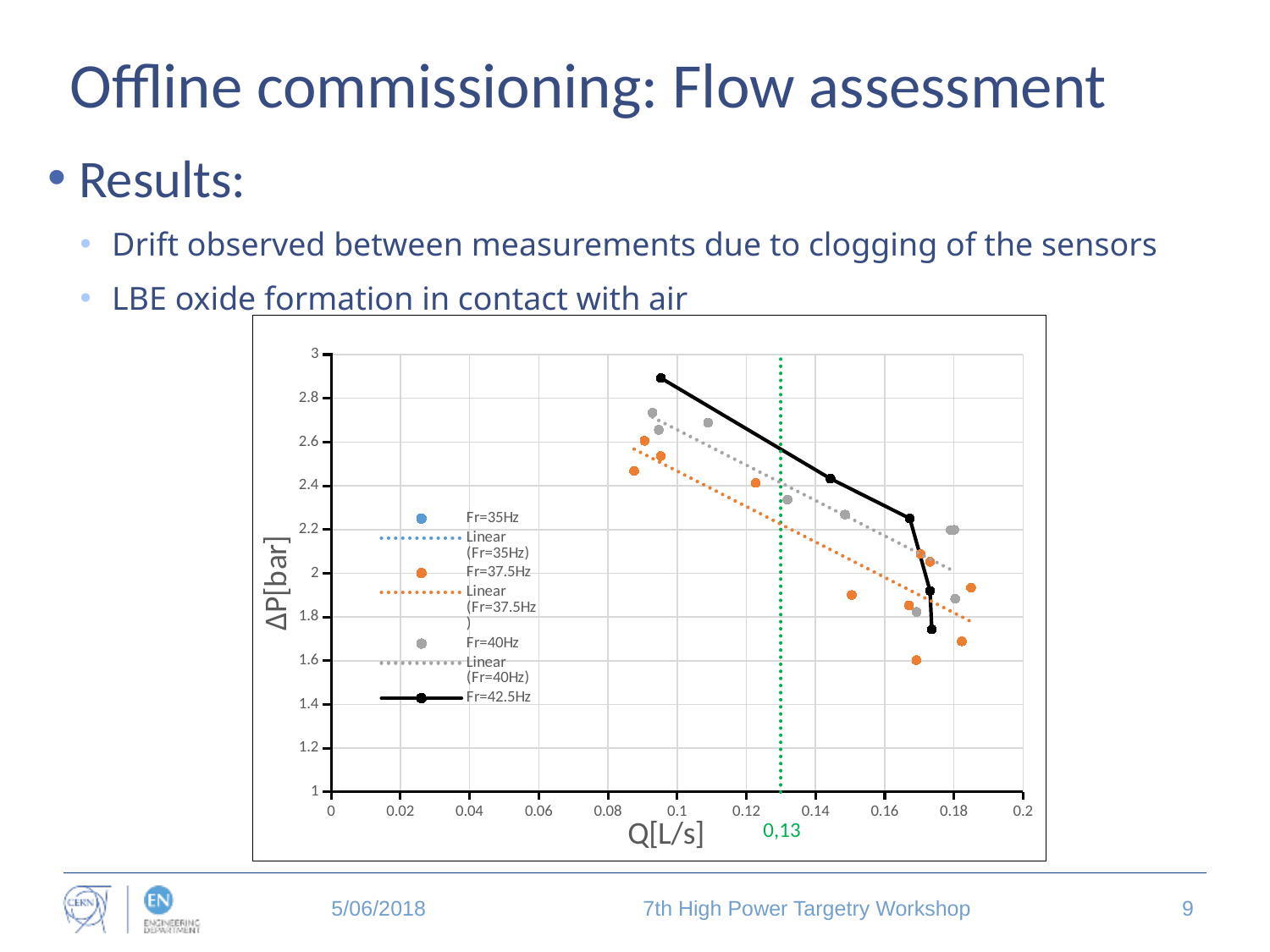
What kind of chart is shown on the slide? scatter chart Is the lowest ΔP value of the Fr=37.5Hz series greater or less than 1.8? less Is the lowest ΔP value of the Fr=42.5Hz series greater or less than 2? less What is the label of the chart's horizontal axis? Q[L/s] Along the Fr=42.5Hz line, does ΔP rise or fall as Q increases? fall At what Q value is the green dotted vertical line drawn? 0,13 How many entries does the chart legend list? 7 Is the highest ΔP value of the Fr=42.5Hz series greater or less than 2.8? greater What is the label of the chart's vertical axis? ΔP[bar] Which series reaches the highest ΔP value on the chart, Fr=42.5Hz or Fr=40Hz? Fr=42.5Hz What is the maximum value shown on the horizontal axis? 0.2